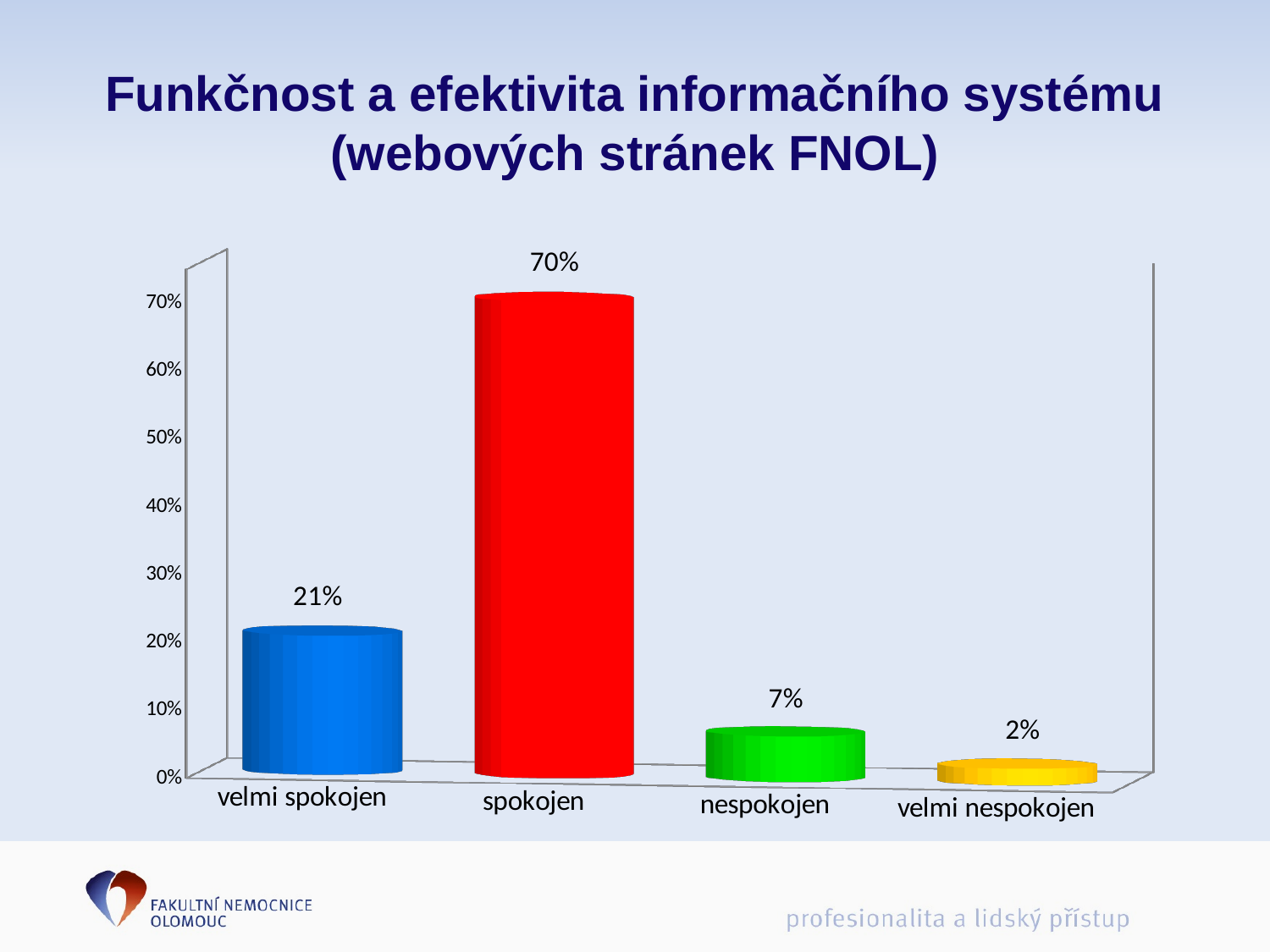
What kind of chart is shown on the slide? bar chart What is the value for "spokojen"? 70% Which category has the highest value? spokojen How many categories are shown on the x axis? 4 What is the value for "velmi nespokojen"? 2% What is the value for "nespokojen"? 7% What is the difference between the values for "spokojen" and "velmi spokojen"? 49% Which category has the lowest value? velmi nespokojen What is the value for "velmi spokojen"? 21% Which is larger, the value for "velmi spokojen" or the value for "nespokojen"? velmi spokojen Is the value for "velmi spokojen" greater or less than 30%? less What colour is the bar for "spokojen"? red